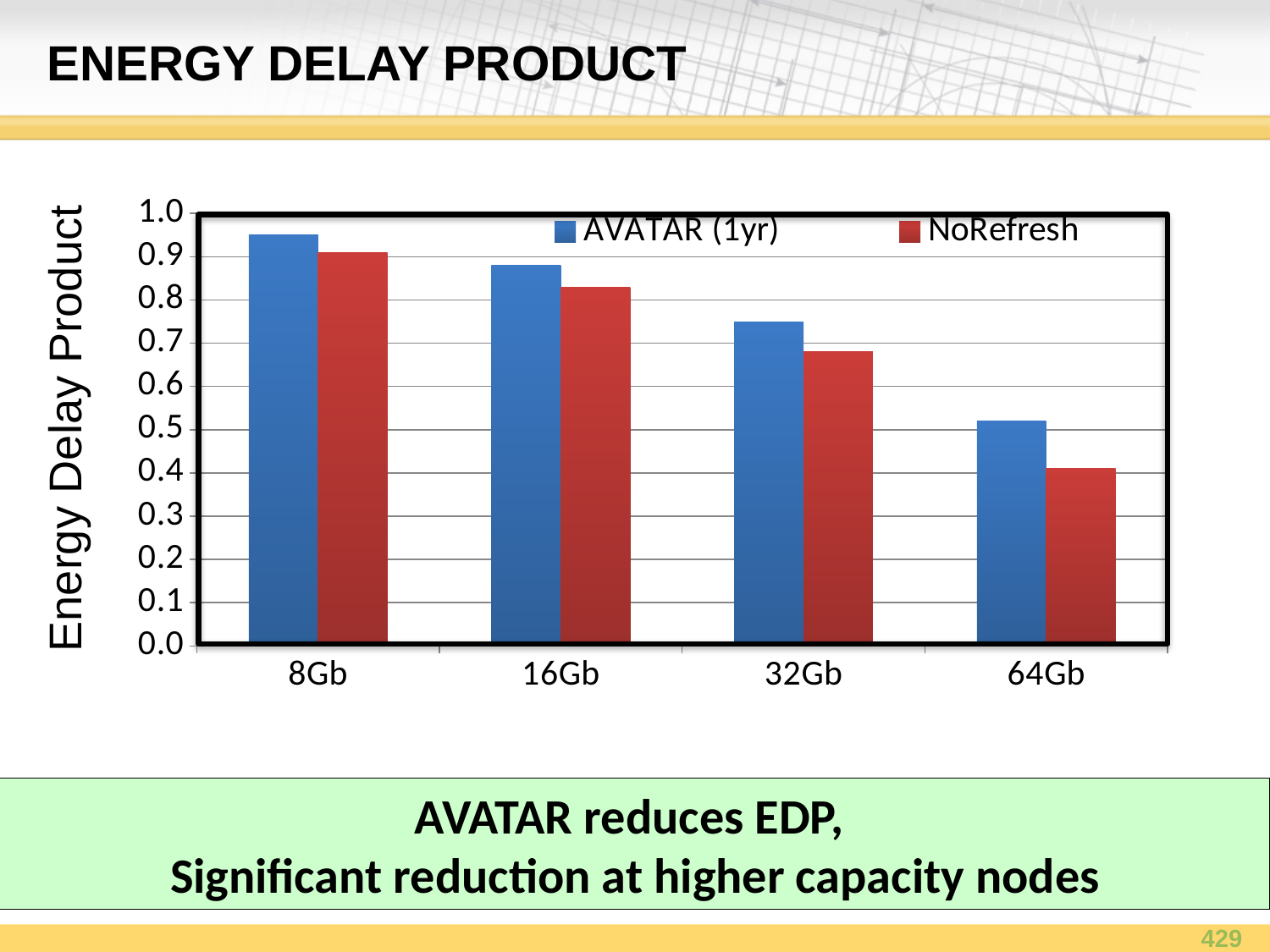
What kind of chart is shown on the slide? bar chart How many capacity categories are shown on the x axis? 4 How many series does the legend list? 2 At 64Gb, which series has the larger value, AVATAR (1yr) or NoRefresh? AVATAR (1yr) What is the label on the vertical axis of the chart? Energy Delay Product Is the NoRefresh value for 64Gb greater or less than 0.5? less Is the NoRefresh value for 32Gb greater or less than 0.6? greater Which capacity has the lowest NoRefresh value? 64Gb Is the AVATAR (1yr) value for 8Gb greater or less than 0.9? greater Which capacity has the highest AVATAR (1yr) value? 8Gb Do the NoRefresh values rise or fall as capacity increases from 8Gb to 64Gb? fall